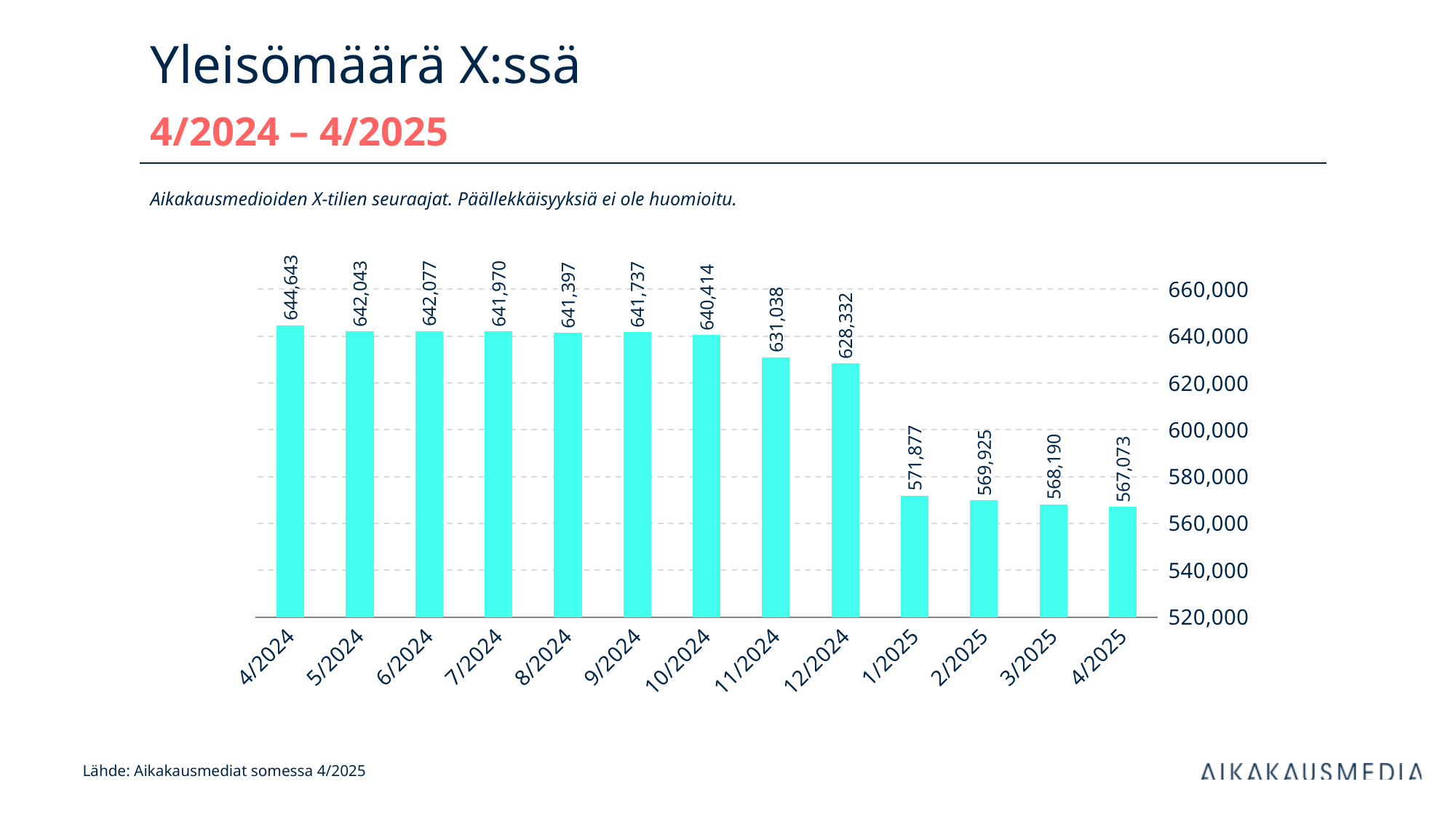
What is the difference between the values for 12/2024 and 1/2025? 56,455 Which is larger, the value for 10/2024 or the value for 11/2024? 10/2024 Which month has the lowest value? 4/2025 Do the values rise or fall from 4/2024 to 4/2025? fall What is the difference between the values for 4/2024 and 4/2025? 77,570 What kind of chart is shown on the slide? bar chart What is the value for 4/2025? 567,073 Which month has the highest value? 4/2024 Is the value for 1/2025 greater or less than 580,000? less What is the value for 4/2024? 644,643 How many months are shown on the x axis? 13 What is the value for 12/2024? 628,332